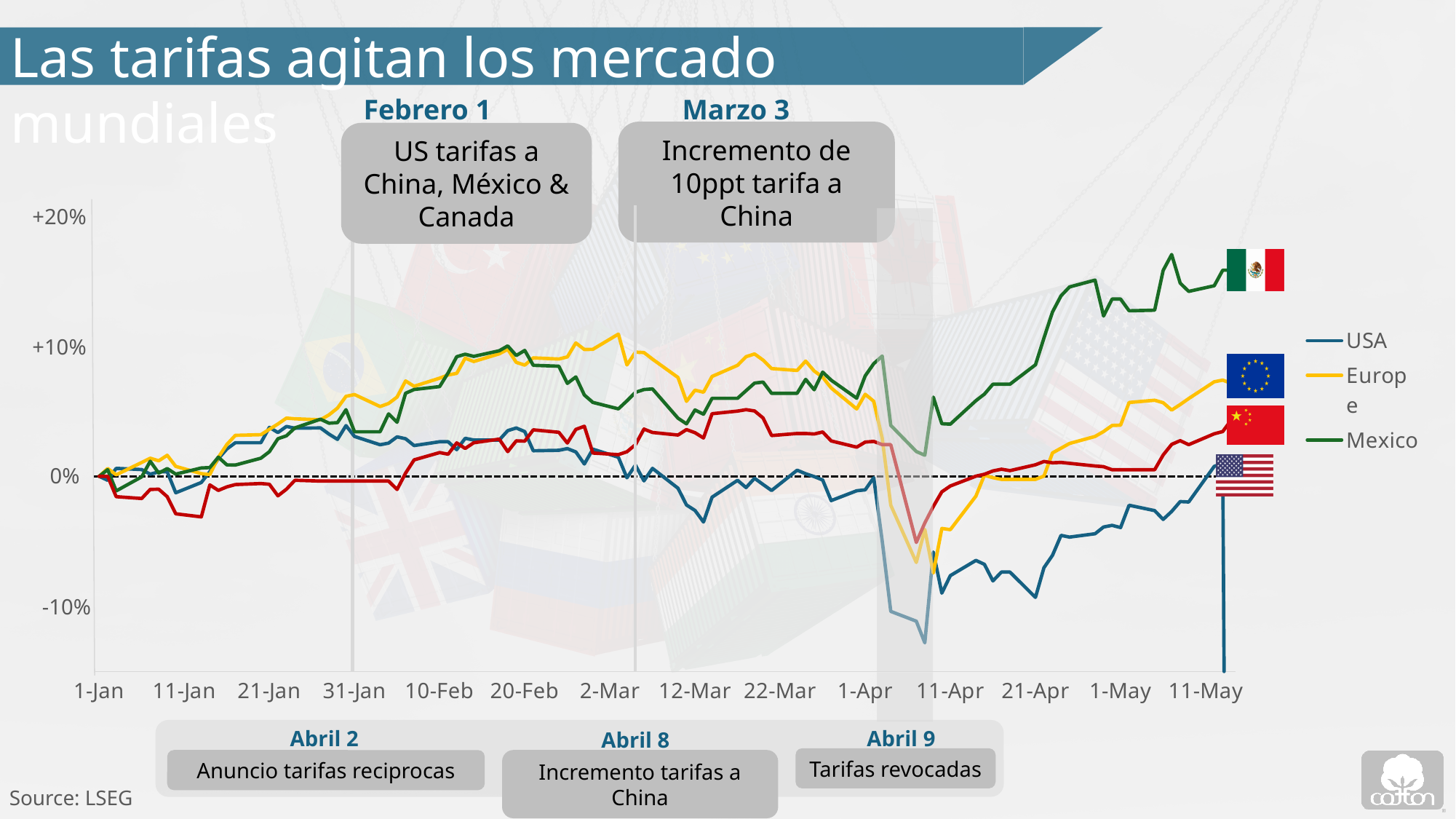
Which series has the highest value at the right end of the chart (11-May)? Mexico Is the value for Mexico at 11-May greater or less than +10%? greater Does the Mexico line rise or fall between 11-Apr and 11-May? rise How many series does the chart's legend list? 3 What is the source cited for the chart? LSEG At 11-May, which is larger: the value for Mexico or the value for USA? Mexico Is the value for Europe at 11-May greater or less than 0%? greater Does the USA line rise or fall between 1-Apr and 9-Apr? fall How many date labels are shown on the x axis? 14 Which series has the lowest value at the right end of the chart (11-May)? USA What kind of chart is shown on the slide? line chart Is the lowest point of the USA line, around 9-Apr, greater or less than -10%? less